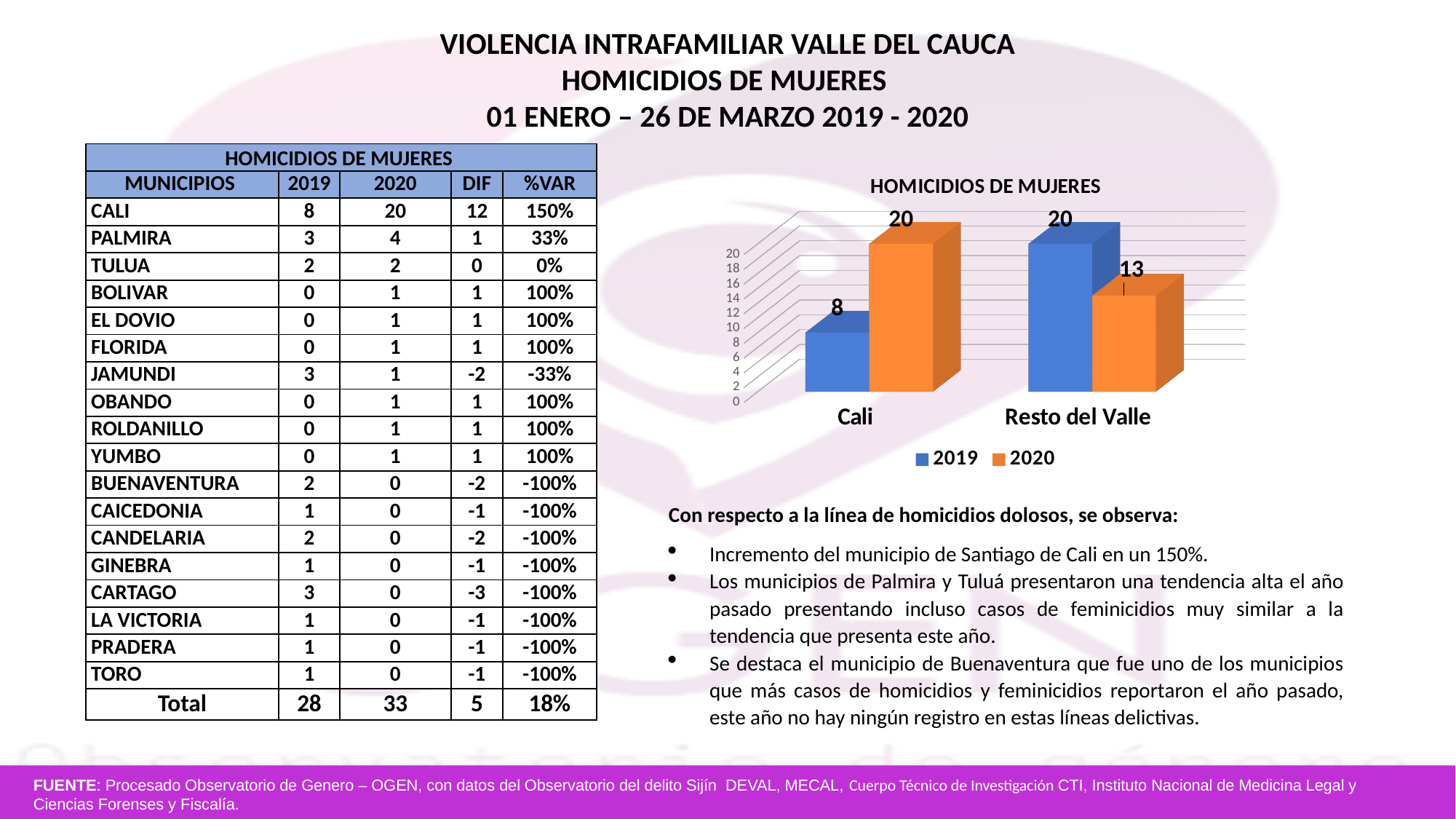
How many series does the chart legend list? 2 What is the title of the chart? HOMICIDIOS DE MUJERES In the 2020 series, which category has the higher value? Cali What is the value for Cali in the 2020 series of the chart? 20 What is the difference between the 2020 and 2019 values for Cali? 12 What is the difference between the 2019 and 2020 values for Resto del Valle? 7 What is the value for Resto del Valle in the 2019 series of the chart? 20 What is the value for Resto del Valle in the 2020 series of the chart? 13 What is the value for Cali in the 2019 series of the chart? 8 In the 2019 series, which category has the lower value? Cali How many categories are shown on the x axis of the chart? 2 For Resto del Valle, which series has the larger value, 2019 or 2020? 2019